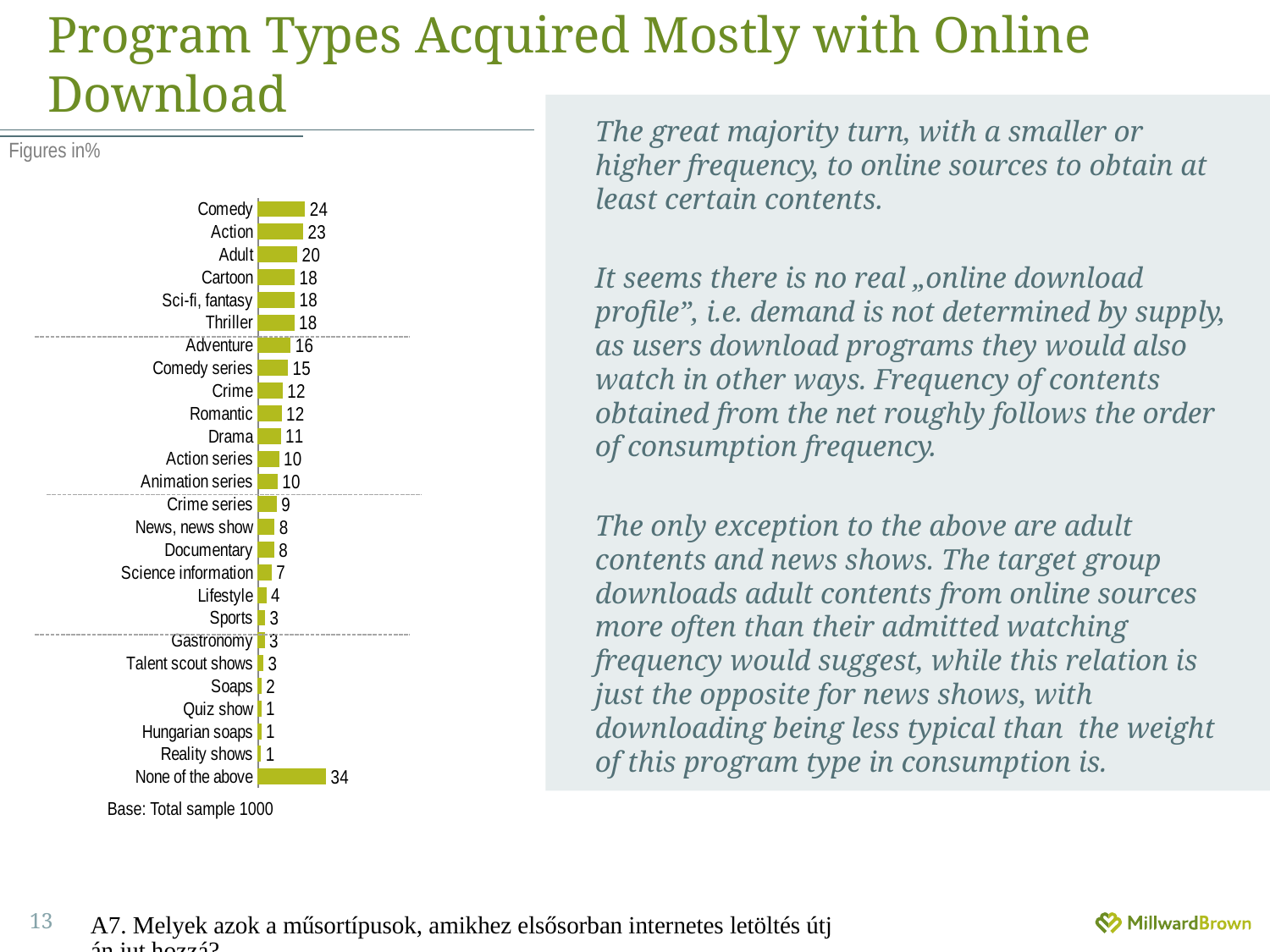
What is the difference between the values for Comedy and Action? 1 What value is shown for Comedy? 24 What is the difference between the values for Adult and Lifestyle? 16 What value is shown for None of the above? 34 Which has a larger value, Adventure or Comedy series? Adventure How many categories are shown in the chart? 26 What value is shown for Adult? 20 Which has a larger value, Sports or Science information? Science information What kind of chart is shown on the slide? Bar chart Which category has the highest value in the chart? None of the above Excluding None of the above, which program type has the highest value? Comedy What value is shown for Documentary? 8